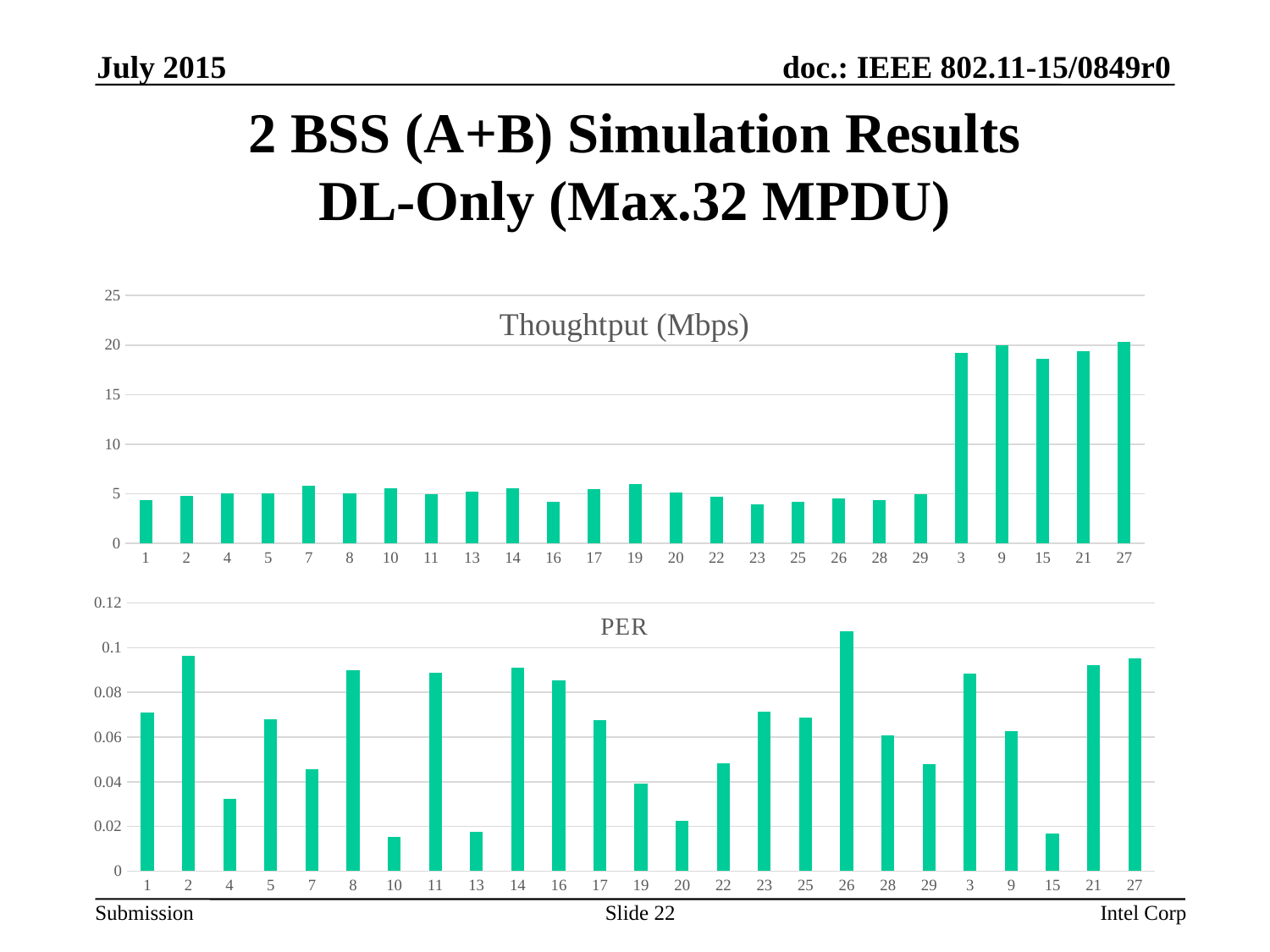
In the PER chart, which is larger, the value for category 2 or the value for category 4? 2 In the PER chart, is the value for category 26 greater or less than 0.1? greater What kind of chart is the Thoughtput (Mbps) chart? bar chart How many categories are shown on the x axis of the PER chart? 25 In the Thoughtput (Mbps) chart, is the value for category 19 greater or less than 5? greater In the Thoughtput (Mbps) chart, is the value for category 3 greater or less than 15? greater In the Thoughtput (Mbps) chart, which is larger, the value for category 3 or the value for category 1? 3 What is the title of the top chart on the slide? Thoughtput (Mbps) In the PER chart, which category has the highest value? 26